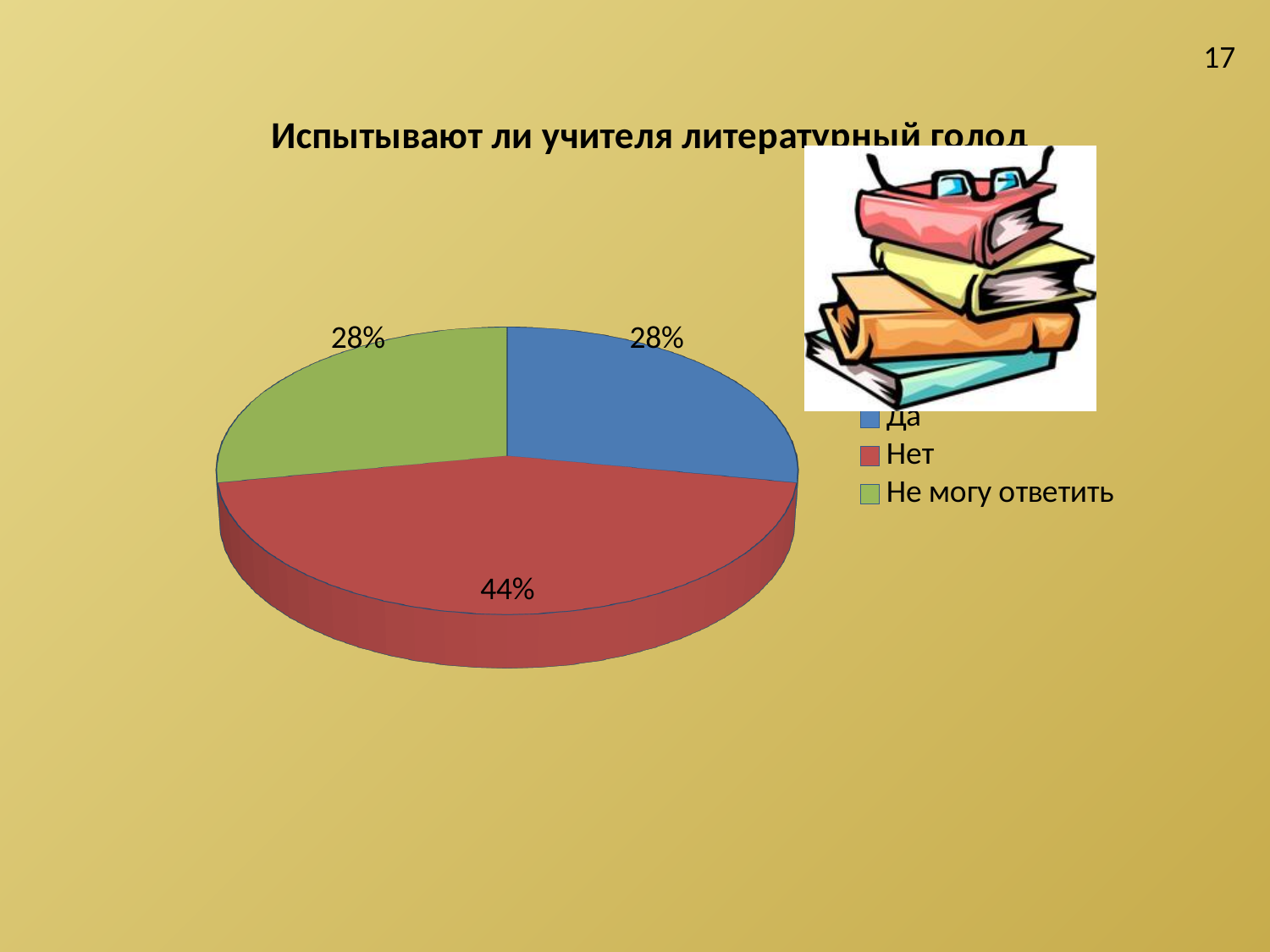
Which is larger, the share for "Нет" or the share for "Не могу ответить"? Нет What colour is the slice for "Нет"? red What share of the pie does "Да" have? 28% How many slices does the pie chart have? 3 What share of the pie does "Нет" have? 44% What is the combined share of "Да" and "Не могу ответить"? 56% How many entries does the legend list? 3 What kind of chart is shown on the slide? pie chart What share of the pie does "Не могу ответить" have? 28% What is the title of the chart? Испытывают ли учителя литературный голод What is the difference between the share for "Нет" and the share for "Да"? 16% Which category has the largest slice of the pie? Нет